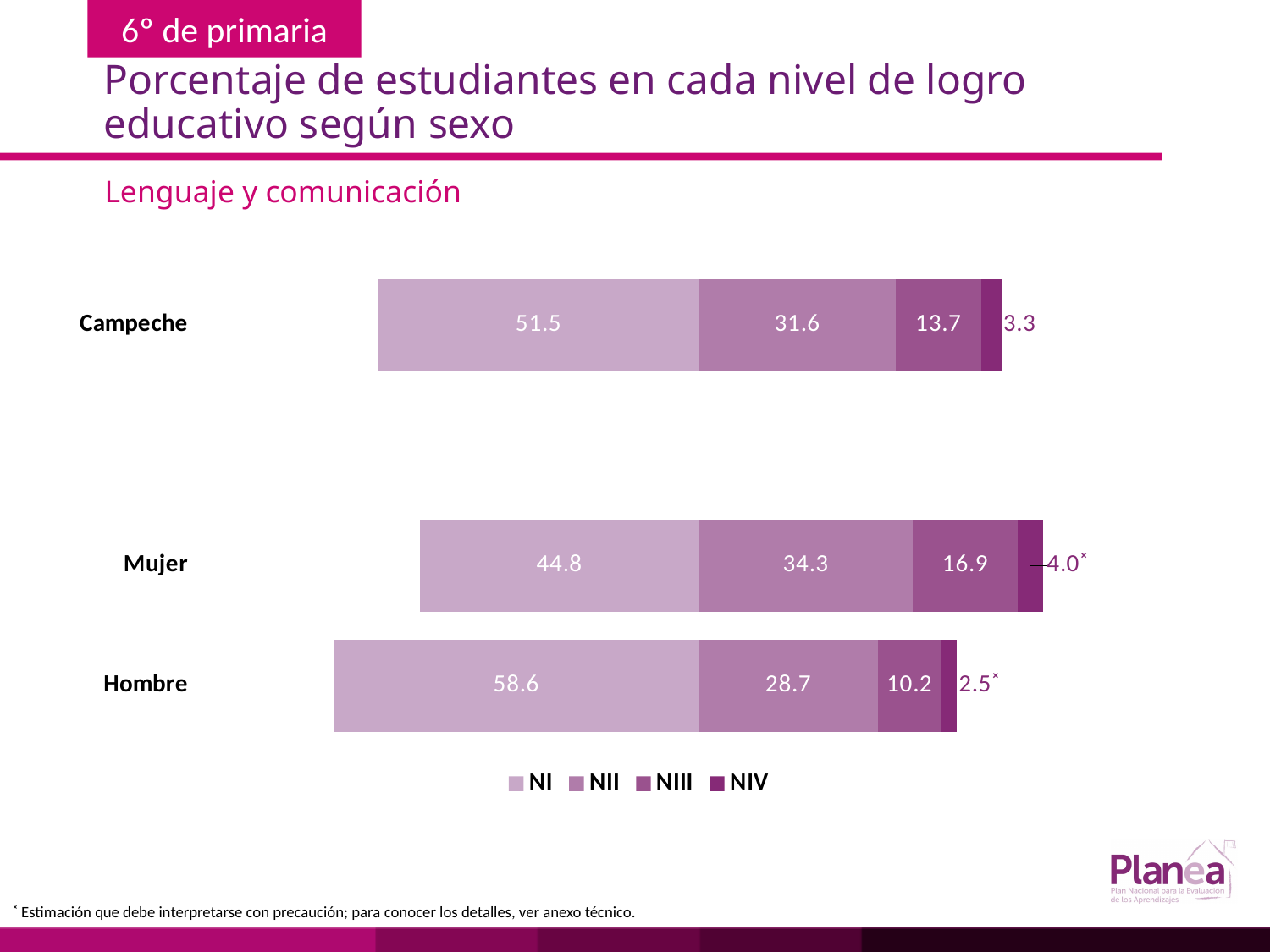
Which category has the lowest NIV value? Hombre Which category has the highest NI value? Hombre What is the NIII value for Campeche? 13.7 What is the NI value for Hombre? 58.6 How many series does the legend list? 4 What is the total of the stacked bar for Mujer? 100.0 What is the NII value for Mujer? 34.3 How many categories are shown on the chart? 3 What is the NIV value for Mujer? 4.0 What kind of chart is shown on the slide? Stacked bar chart What is the difference between the NI values for Hombre and Mujer? 13.8 Which is larger, the NIII value for Mujer or the NIII value for Campeche? Mujer